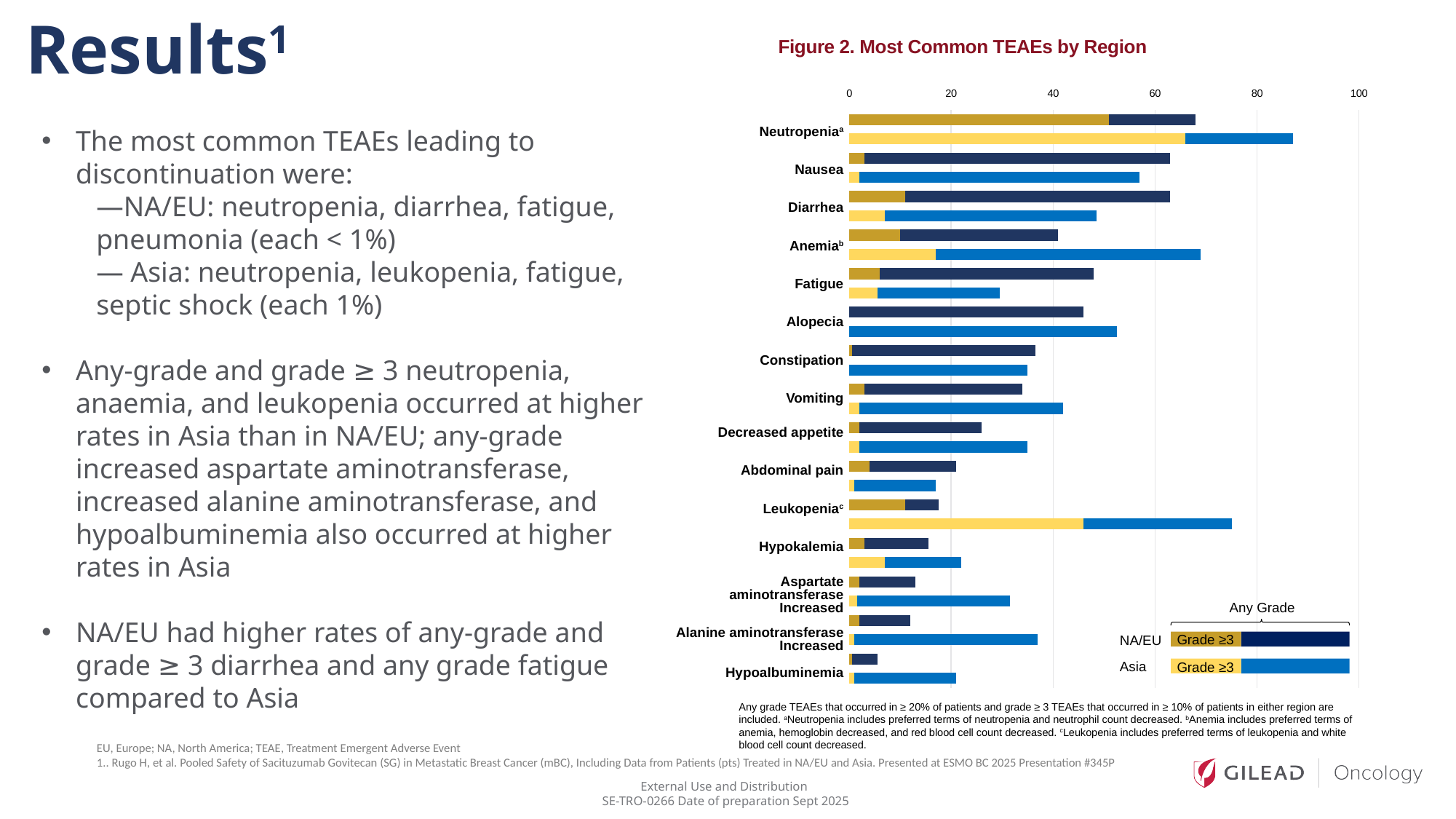
What is the title of the chart on the slide? Figure 2. Most Common TEAEs by Region Is the any-grade rate of neutropenia in Asia greater or less than 80? greater Is the any-grade rate of leukopenia in Asia greater or less than 60? greater How many adverse event categories are listed on the y axis of the chart? 15 Which adverse event has the lowest any-grade rate in NA/EU? Hypoalbuminemia How many regions does the chart legend list? 2 Is the any-grade rate of fatigue in Asia greater or less than 40? less Which region has the higher any-grade rate of diarrhea, NA/EU or Asia? NA/EU Which adverse event has the highest any-grade rate in Asia? Neutropenia What kind of chart is shown in Figure 2? bar chart Which region has the higher any-grade rate of anemia, NA/EU or Asia? Asia